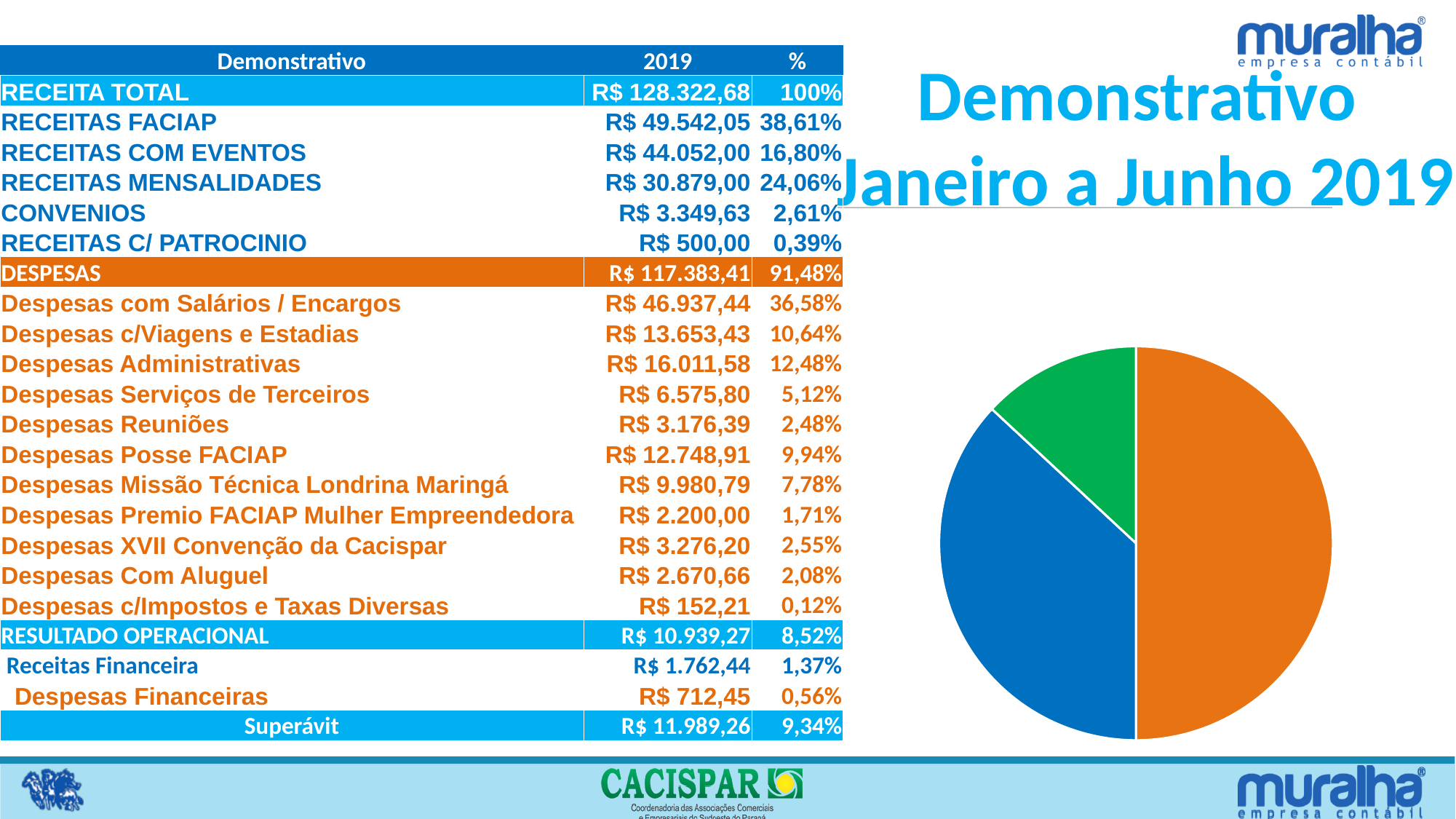
In the pie chart, is the blue slice or the green slice larger? blue What three colours are used for the slices of the pie chart? orange, blue and green Which colour slice is the largest in the pie chart? orange What kind of chart is shown on the right side of the slide? pie chart Which colour slice is the smallest in the pie chart? green Does the pie chart display a legend? No In the pie chart, is the orange slice or the blue slice larger? orange How many slices does the pie chart have? 3